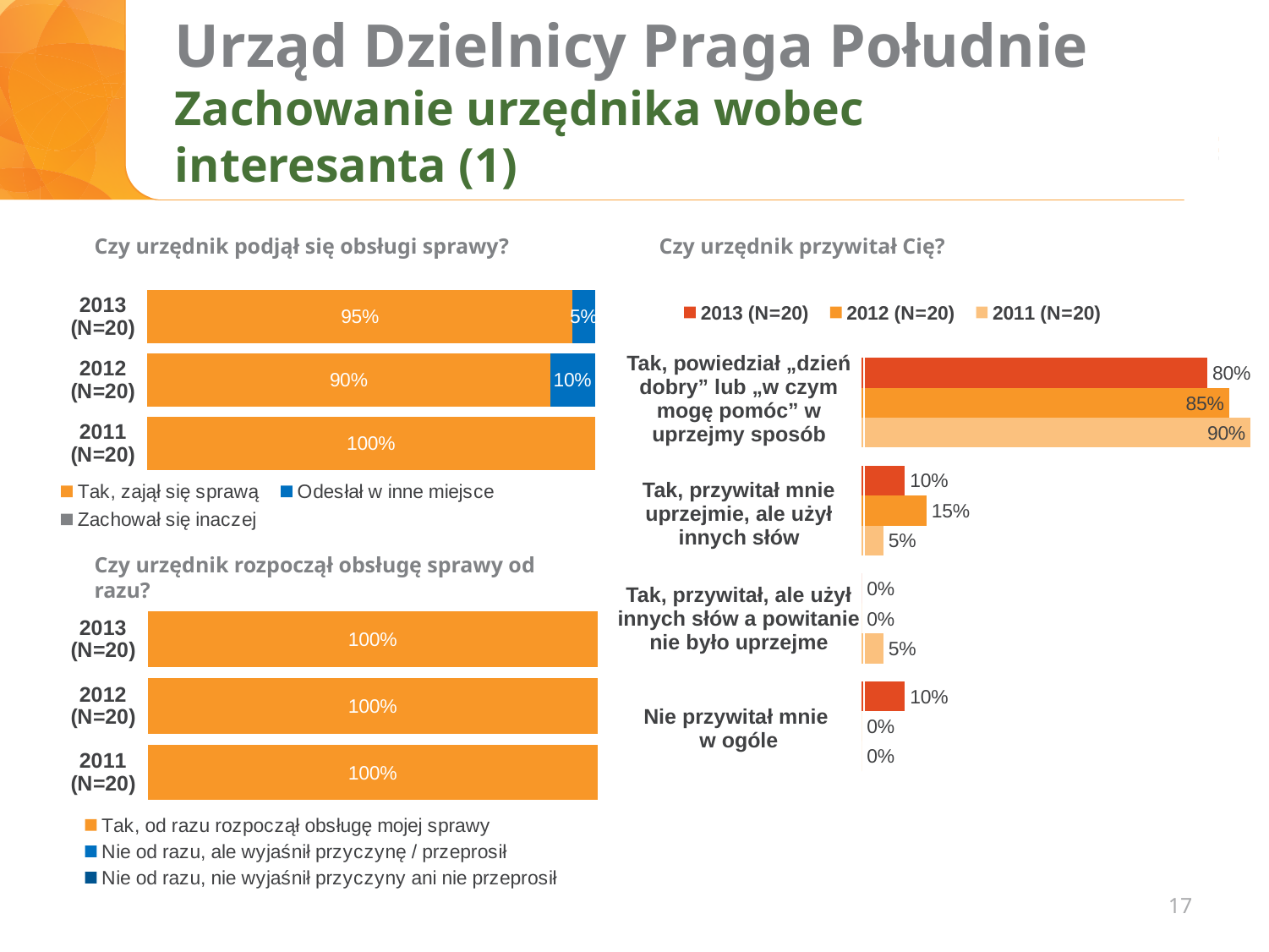
In the chart "Czy urzędnik przywitał Cię?", what is the value for 2011 (N=20) for "Tak, powiedział „dzień dobry” lub „w czym mogę pomóc” w uprzejmy sposób"? 90% In the chart "Czy urzędnik rozpoczął obsługę sprawy od razu?", how many years are shown? 3 In the chart "Czy urzędnik podjął się obsługi sprawy?", how many legend entries are there? 3 In the chart "Czy urzędnik przywitał Cię?", what is the difference between the 2011 (N=20) and 2013 (N=20) values for "Tak, powiedział „dzień dobry” lub „w czym mogę pomóc” w uprzejmy sposób"? 10% In the chart "Czy urzędnik przywitał Cię?", which year has the highest value for "Nie przywitał mnie w ogóle"? 2013 (N=20) In the chart "Czy urzędnik podjął się obsługi sprawy?", which year has the highest share of "Tak, zajął się sprawą"? 2011 (N=20) In the chart "Czy urzędnik przywitał Cię?", what is the value for 2012 (N=20) for "Tak, przywitał mnie uprzejmie, ale użył innych słów"? 15% In the chart "Czy urzędnik podjął się obsługi sprawy?", what percentage for 2012 (N=20) is "Odesłał w inne miejsce"? 10% In the chart "Czy urzędnik przywitał Cię?", how many series does the legend list? 3 What type of chart is "Czy urzędnik przywitał Cię?"? Bar chart In the chart "Czy urzędnik podjął się obsługi sprawy?", what percentage for 2013 (N=20) is "Tak, zajął się sprawą"? 95% In the chart "Czy urzędnik rozpoczął obsługę sprawy od razu?", what is the value for 2012 (N=20) for "Tak, od razu rozpoczął obsługę mojej sprawy"? 100%